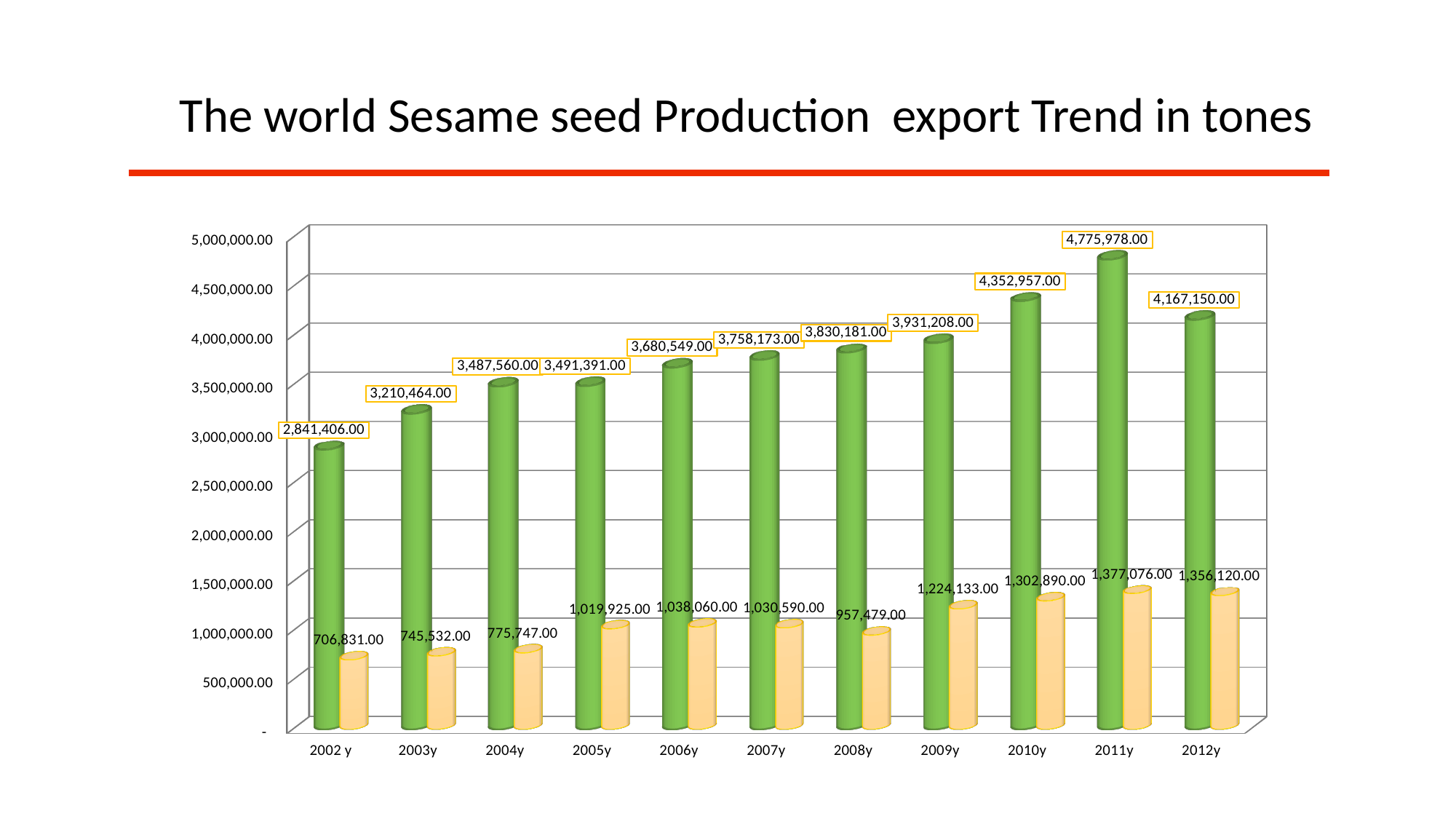
How many years are shown on the x axis? 11 What is the title of the slide? The world Sesame seed Production export Trend in tones In which year is the green bar highest? 2011y What is the value of the green bar for 2012y? 4,167,150.00 What is the value of the yellow bar for 2009y? 1,224,133.00 What is the value of the green bar for 2002 y? 2,841,406.00 Which is larger, the yellow bar for 2008y or the yellow bar for 2007y? 2007y What is the difference between the green bar values for 2011y and 2012y? 608,828.00 What is the value of the yellow bar for 2005y? 1,019,925.00 In which year is the yellow bar lowest? 2002 y What kind of chart is shown on the slide? Bar chart What is the difference between the yellow bar values for 2011y and 2002 y? 670,245.00